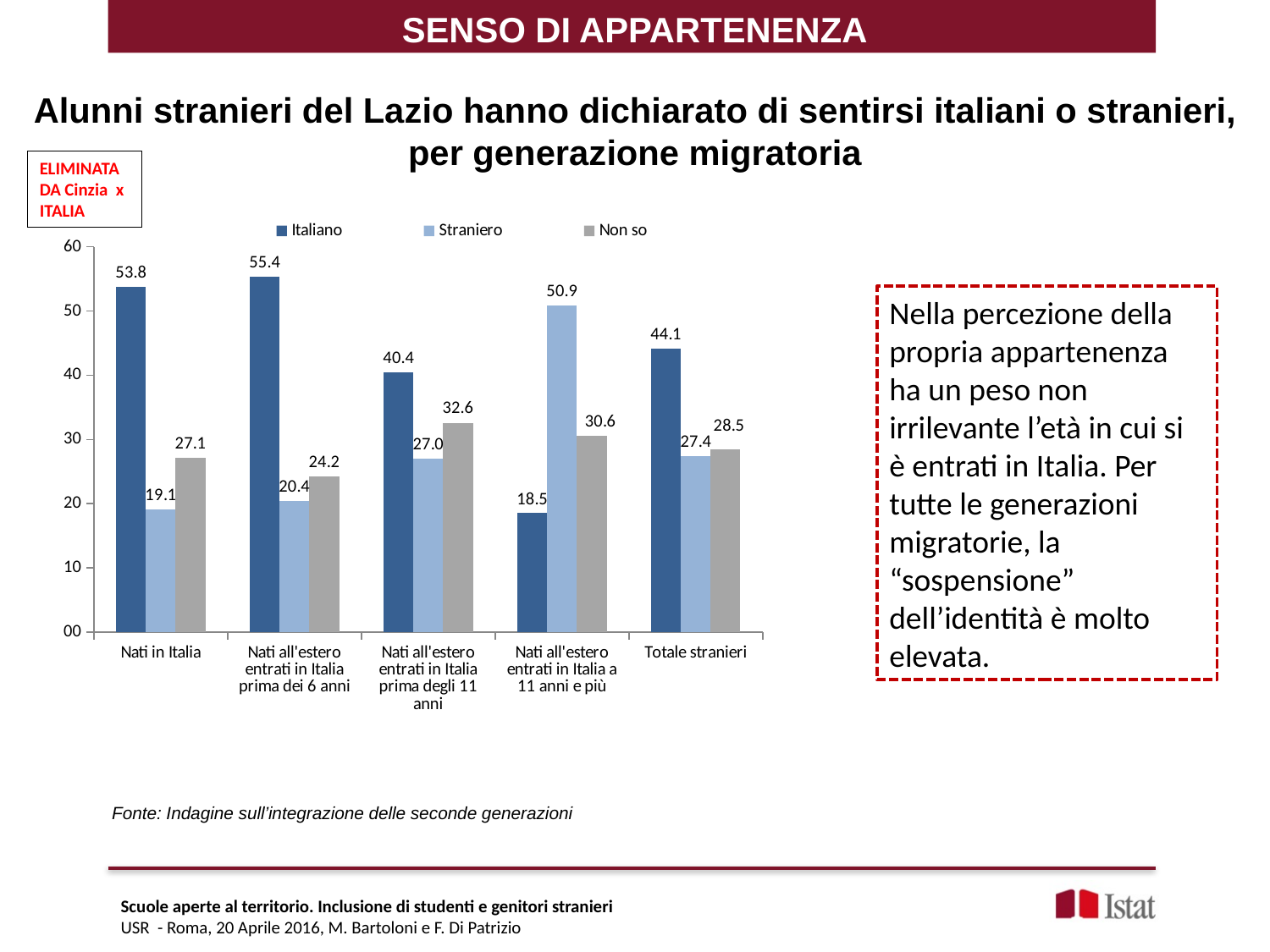
Which category has the lowest value for the 'Straniero' series? Nati in Italia What is the value of 'Non so' for 'Totale stranieri'? 28.5 What is the value of 'Italiano' for 'Nati in Italia'? 53.8 Is the 'Italiano' value for 'Totale stranieri' greater or less than 40? greater How many series does the legend list? 3 What type of chart is shown on the slide? bar chart What is the value of 'Straniero' for 'Nati all'estero entrati in Italia a 11 anni e più'? 50.9 For 'Nati all'estero entrati in Italia prima degli 11 anni', which is larger: 'Straniero' or 'Non so'? Non so What is the difference between the 'Italiano' and 'Straniero' values for 'Nati in Italia'? 34.7 Which category has the highest value for the 'Italiano' series? Nati all'estero entrati in Italia prima dei 6 anni Which series is shown in the lightest blue colour in the legend? Straniero How many categories are shown on the x axis? 5